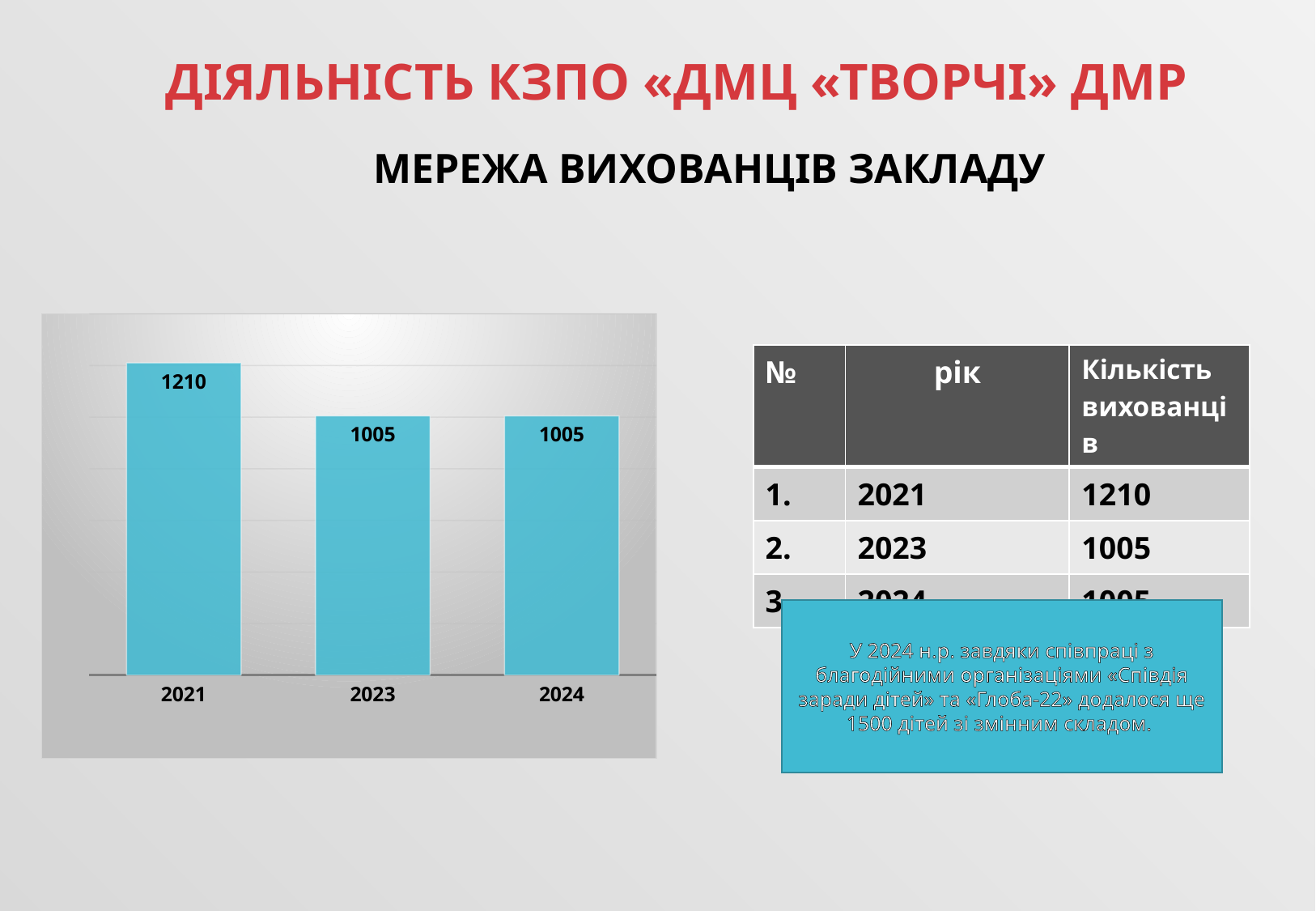
Which year has the highest value in the bar chart? 2021 What kind of chart is shown on the slide? bar chart What is the value for 2024 in the bar chart? 1005 Which is larger, the value for 2021 or the value for 2024? 2021 Do the values rise or fall from 2021 to 2023? fall What colour are the bars in the chart? blue What is the total of the values for 2023 and 2024? 2010 What is the value for 2021 in the bar chart? 1210 Are the values for 2023 and 2024 equal? yes What is the difference between the values for 2021 and 2023? 205 What is the value for 2023 in the bar chart? 1005 How many bars are shown in the chart? 3